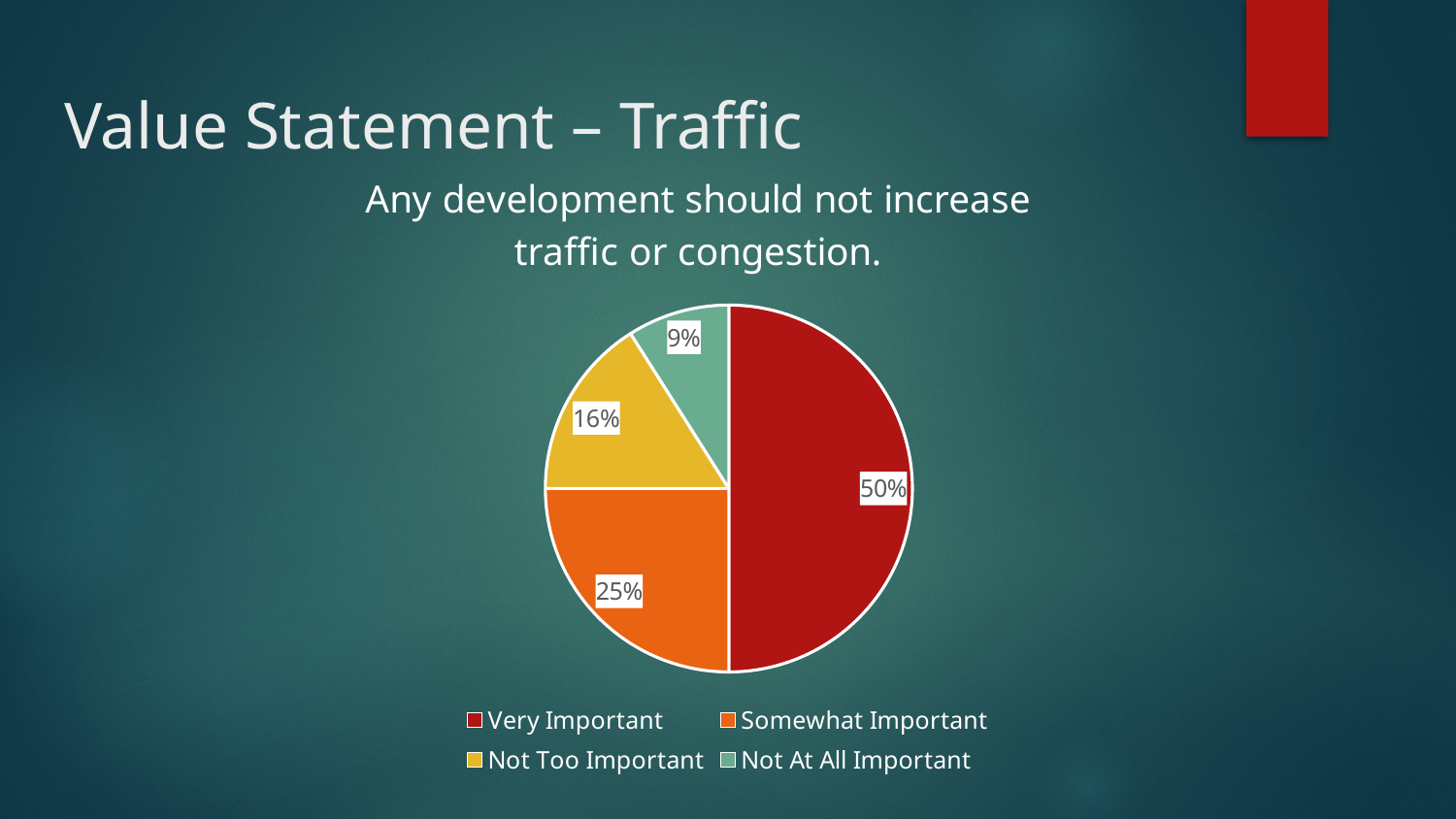
Which response category has the smallest share of the pie? Not At All Important What percentage of respondents rated the traffic value statement as Not At All Important? 9% What percentage of respondents rated the traffic value statement as Somewhat Important? 25% Which response category has the largest share of the pie? Very Important How many categories does the legend list? 4 What is the combined percentage for Very Important and Somewhat Important? 75% What colour is the Very Important slice? red Which is larger, the share for Not Too Important or the share for Not At All Important? Not Too Important What is the difference in percentage points between Very Important and Somewhat Important? 25 What percentage of respondents rated the traffic value statement as Very Important? 50% What kind of chart is shown on the slide? pie chart What percentage of respondents rated the traffic value statement as Not Too Important? 16%